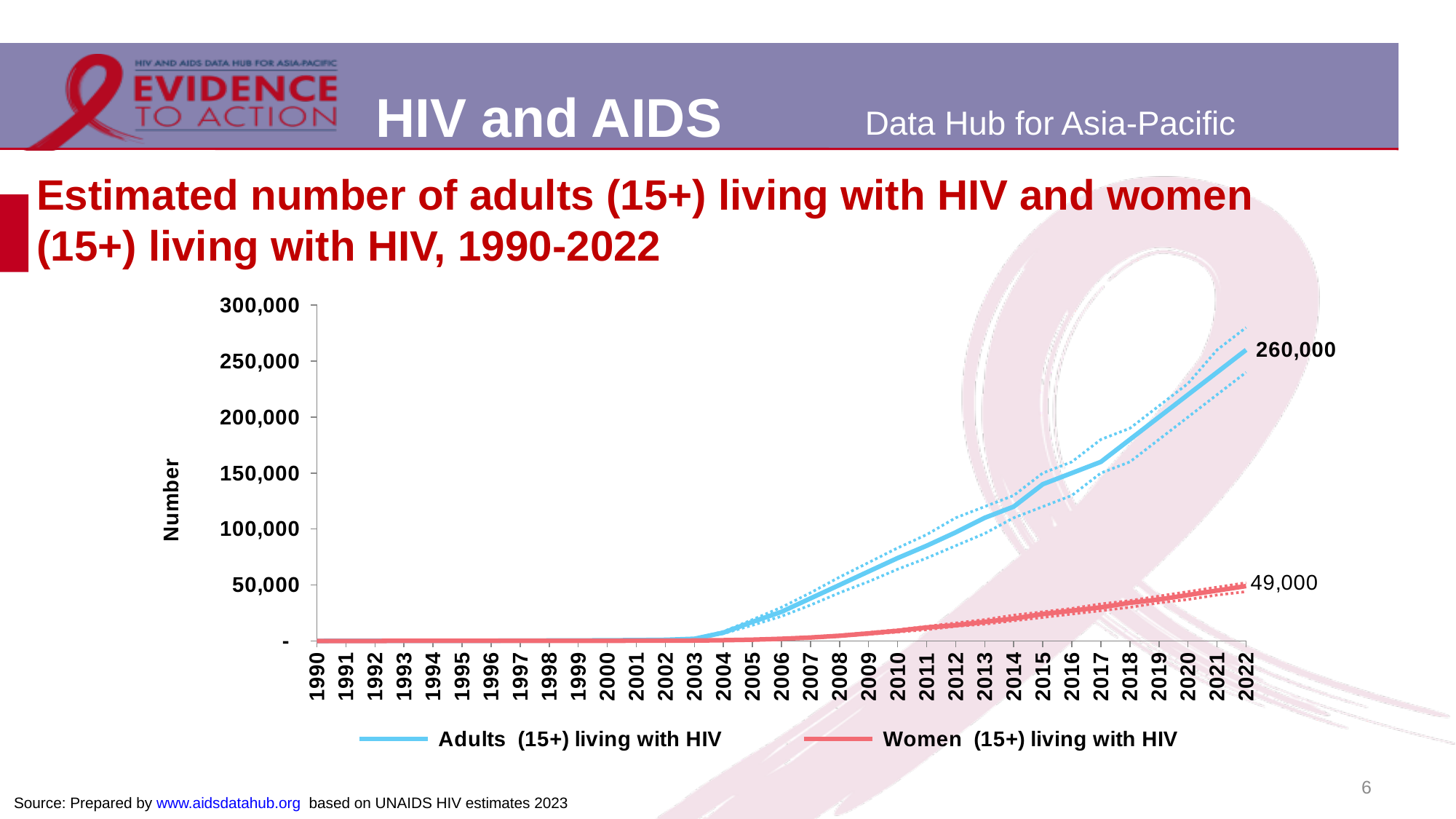
In which year does the adults (15+) living with HIV series reach its highest value? 2022 What is the estimated number of women (15+) living with HIV in 2022? 49,000 What kind of chart is shown on the slide? Line chart Do the values for adults (15+) living with HIV rise or fall from 2003 to 2022? Rise Is the value for adults (15+) living with HIV in 2010 greater or less than 100,000? less Is the value for adults (15+) living with HIV in 2015 greater or less than 100,000? greater What is the label on the vertical axis of the chart? Number What is the estimated number of adults (15+) living with HIV in 2022? 260,000 In 2022, which series has the larger value: adults (15+) living with HIV or women (15+) living with HIV? Adults (15+) living with HIV What is the difference between the 2022 values for adults (15+) living with HIV and women (15+) living with HIV? 211,000 Is the value for women (15+) living with HIV in 2018 greater or less than 50,000? less How many series does the legend list? 2